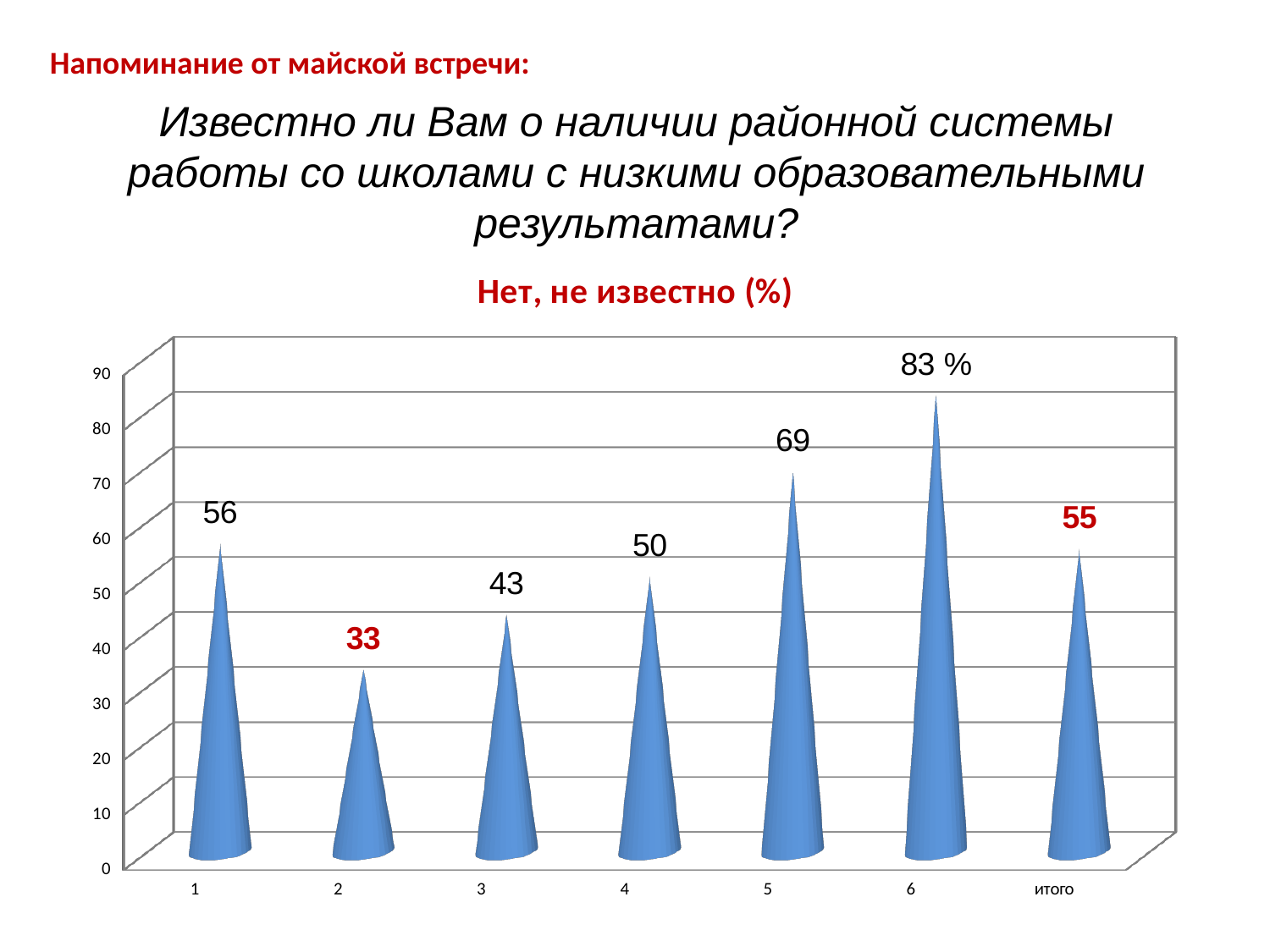
What is the value for category 2? 33 What kind of chart is shown on the slide? bar chart What is the title of the chart? Нет, не известно (%) How many categories are shown on the x axis? 7 Which is larger, the value for category 3 or the value for category 4? category 4 What is the difference between the values for category 5 and category 4? 19 Which category has the lowest value? 2 What is the value for category 6? 83 % What is the value for the category "итого"? 55 Which category has the highest value? 6 Is the value for category 5 greater or less than 60? greater What is the value for category 1? 56